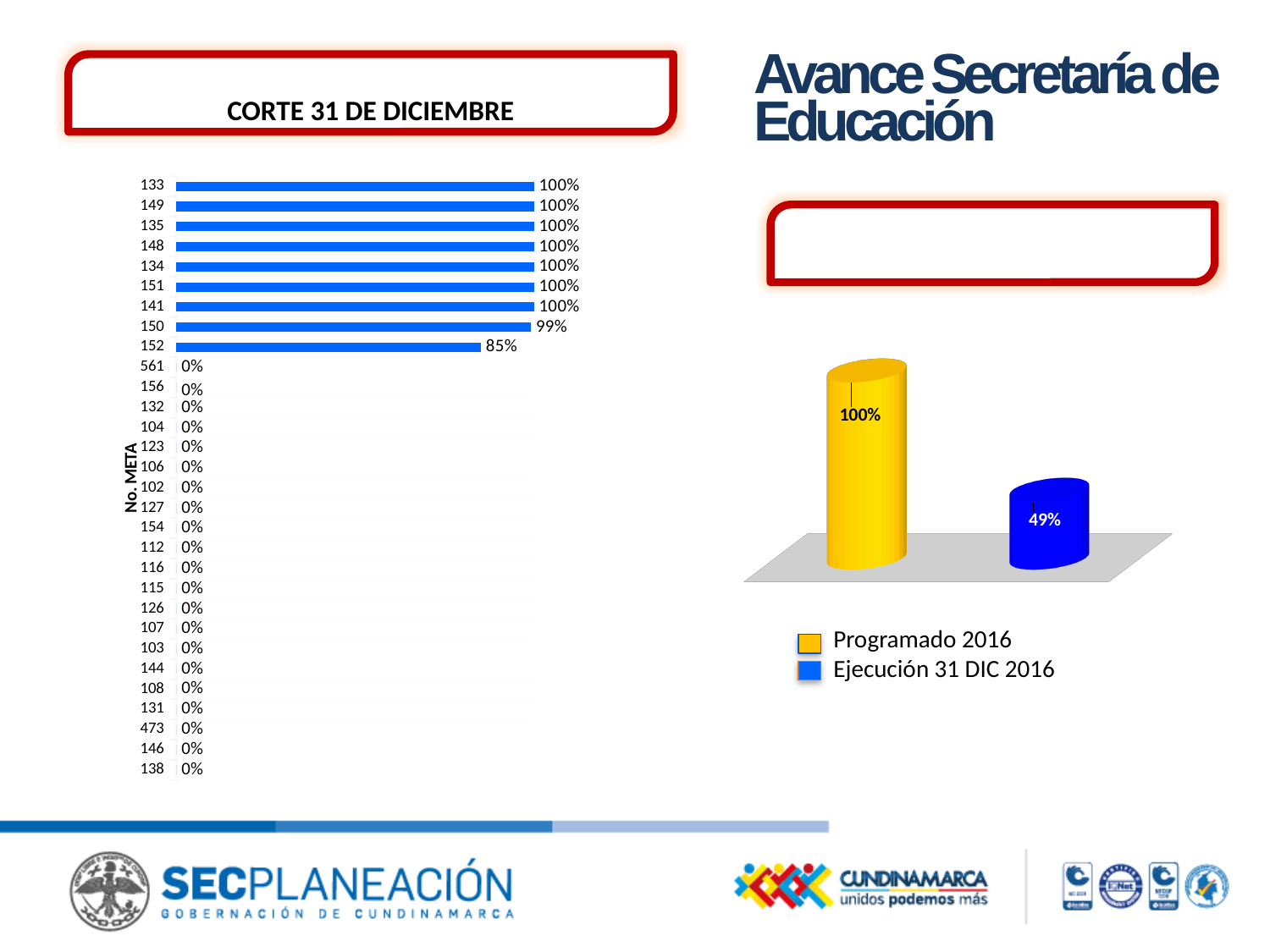
In the right chart, what is the value for Ejecución 31 DIC 2016? 49% In the left bar chart, what is the value shown for meta 152? 85% How many metas (categories) are listed in the left bar chart? 30 How many series does the legend of the right chart list? 2 In the right chart, what is the value for Programado 2016? 100% In the left bar chart, what is the difference between the values for meta 133 and meta 152? 15% What kind of chart is the left chart on the slide? Bar chart In the left bar chart, which has the larger value, meta 150 or meta 152? 150 In the left bar chart, what is the value shown for meta 150? 99% In the left bar chart, what is the value shown for meta 561? 0% In the right chart, what is the difference between Programado 2016 and Ejecución 31 DIC 2016? 51% In the left bar chart, how many metas show a value of 100%? 7